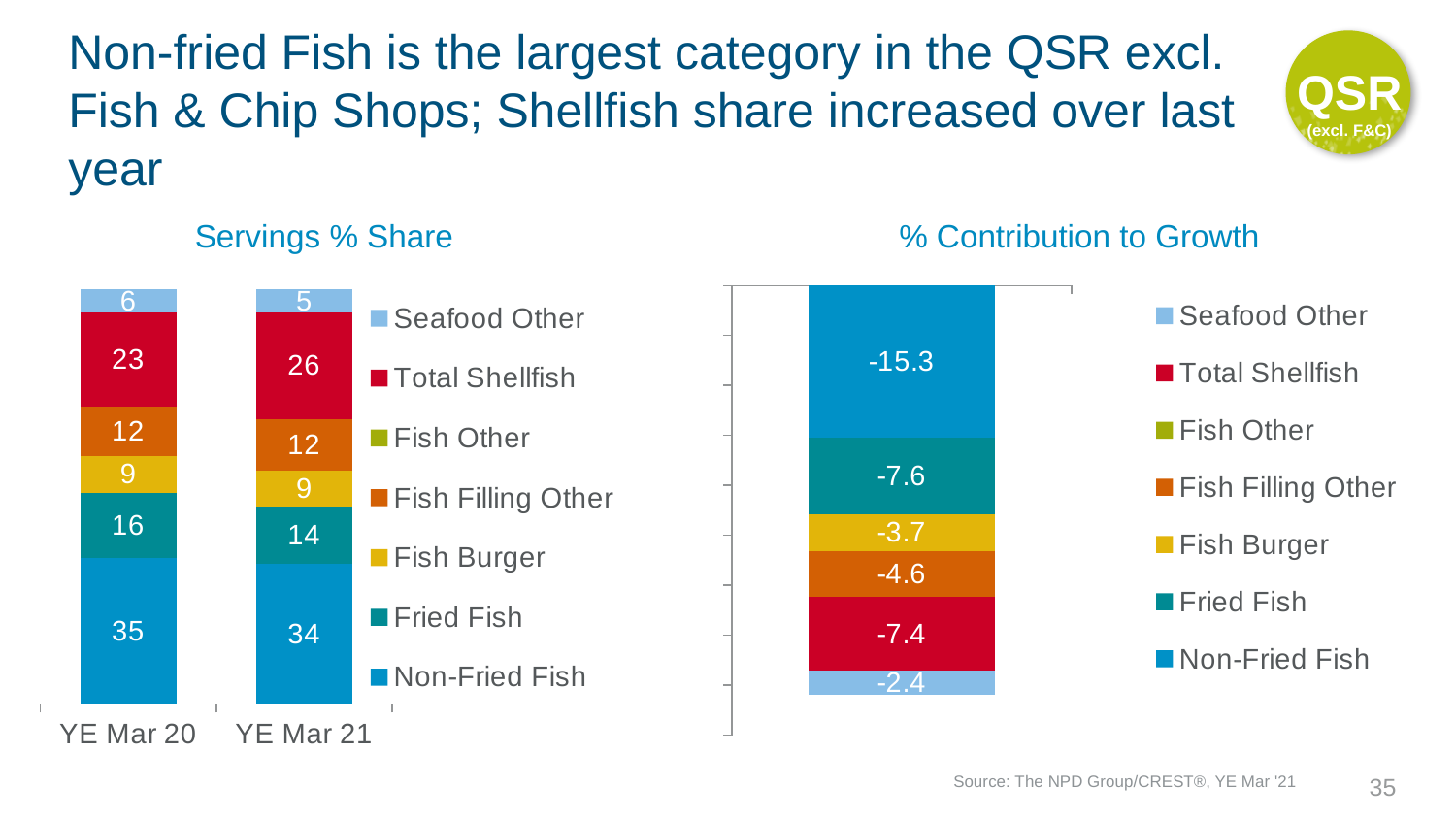
How many series does the legend of the Servings % Share chart list? 7 How many bars are shown in the Servings % Share chart? 2 In the Servings % Share chart, is the Fried Fish value larger in YE Mar 20 or YE Mar 21? YE Mar 20 In the % Contribution to Growth chart, what is the value for Seafood Other? -2.4 In the % Contribution to Growth chart, what is the value for Non-Fried Fish? -15.3 In the Servings % Share chart, what is the value for Total Shellfish in YE Mar 21? 26 In the % Contribution to Growth chart, what is the value for Fish Burger? -3.7 In the Servings % Share chart, by how much did the Total Shellfish value change from YE Mar 20 to YE Mar 21? 3 In the Servings % Share chart, what is the value for Non-Fried Fish in YE Mar 20? 35 In the % Contribution to Growth chart, which category has the lowest (most negative) value? Non-Fried Fish What kind of chart is the % Contribution to Growth chart? Stacked bar chart In the Servings % Share chart, what is the value for Fried Fish in YE Mar 21? 14